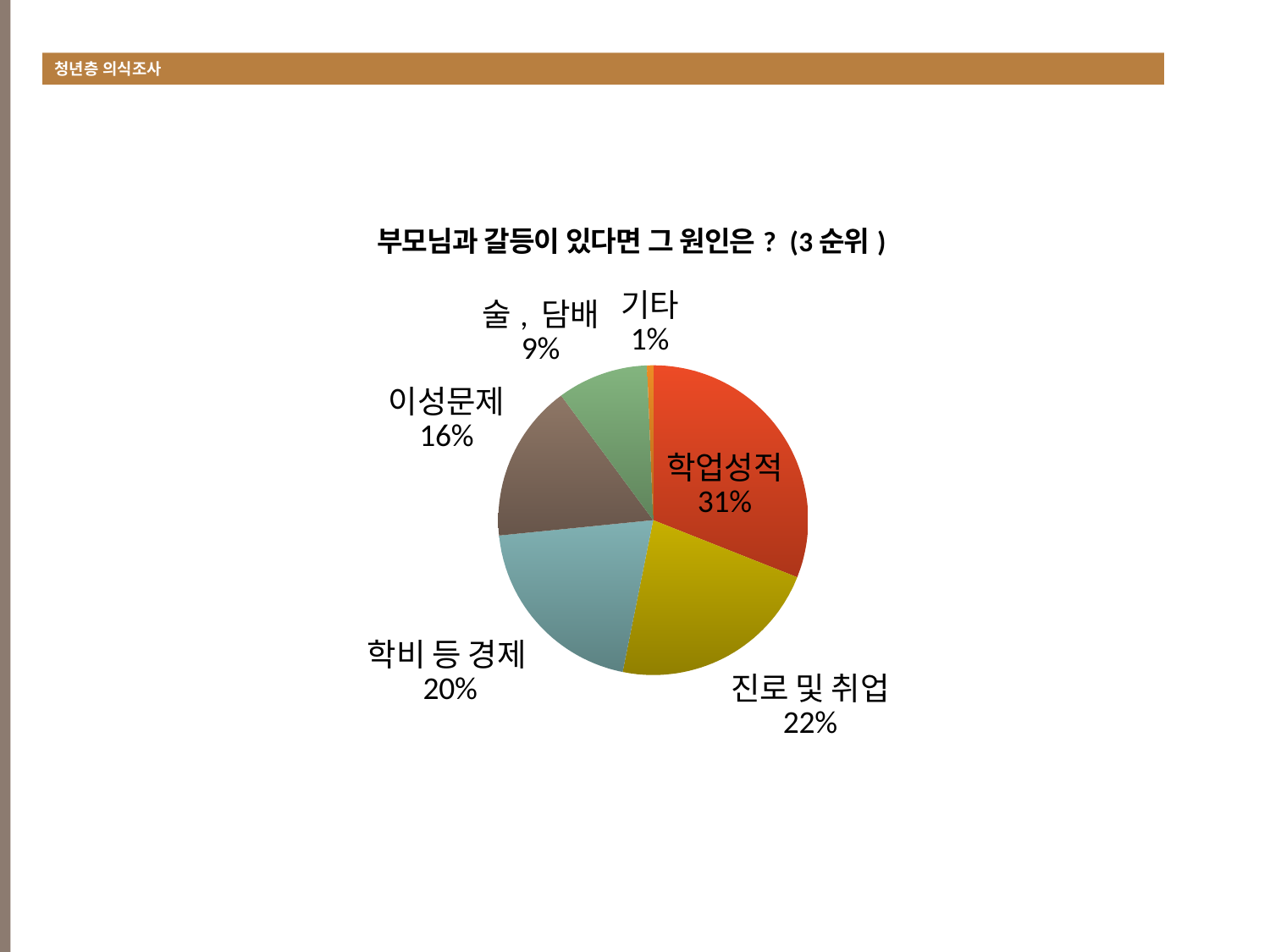
What percentage is shown for 학업성적? 31% What percentage is shown for 학비 등 경제? 20% Which category has the largest share of the pie? 학업성적 Which is larger, the share for 이성문제 or the share for 술 , 담배? 이성문제 What percentage is shown for 이성문제? 16% What percentage is shown for 진로 및 취업? 22% How many categories are shown in the pie chart? 6 What is the difference in percentage points between 학업성적 and 진로 및 취업? 9 Which category has the smallest share of the pie? 기타 What percentage is shown for 술 , 담배? 9% What is the title of the chart? 부모님과 갈등이 있다면 그 원인은 ? (3 순위 ) What type of chart is shown on the slide? pie chart